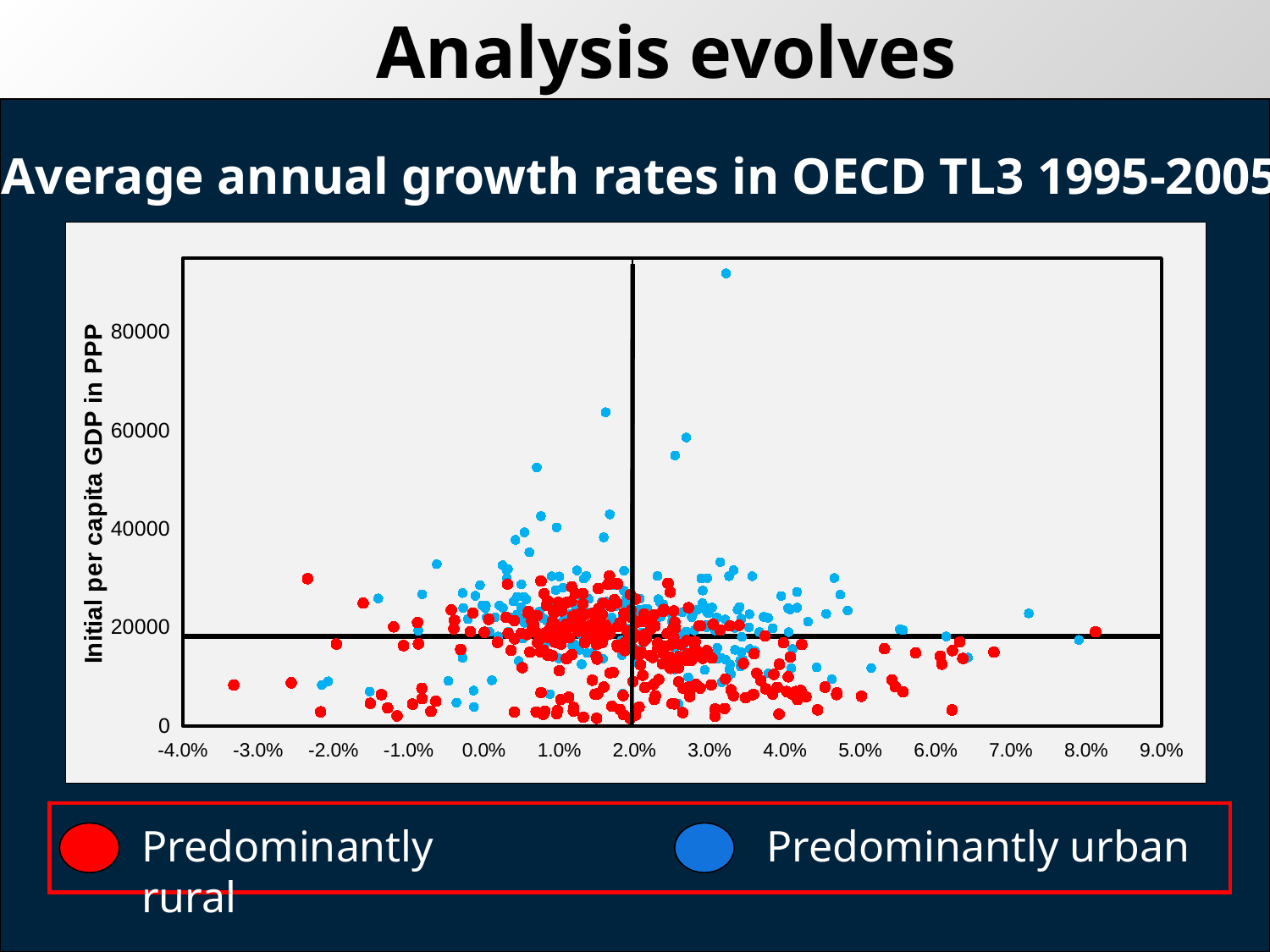
Which series contains the point with the highest initial per capita GDP? Predominantly urban Which series has the point with the highest initial per capita GDP: Predominantly rural or Predominantly urban? Predominantly urban Which series is shown with red markers? Predominantly rural Is the initial per capita GDP of the highest point on the chart greater or less than 80000? greater What is the highest tick label shown on the y axis? 80000 How many series does the legend list? 2 What is the title of the chart? Average annual growth rates in OECD TL3 1995-2005 How many tick labels are shown on the x axis? 14 Is the initial per capita GDP of the highest Predominantly rural point greater or less than 40000? less What kind of chart is shown on the slide? Scatter plot